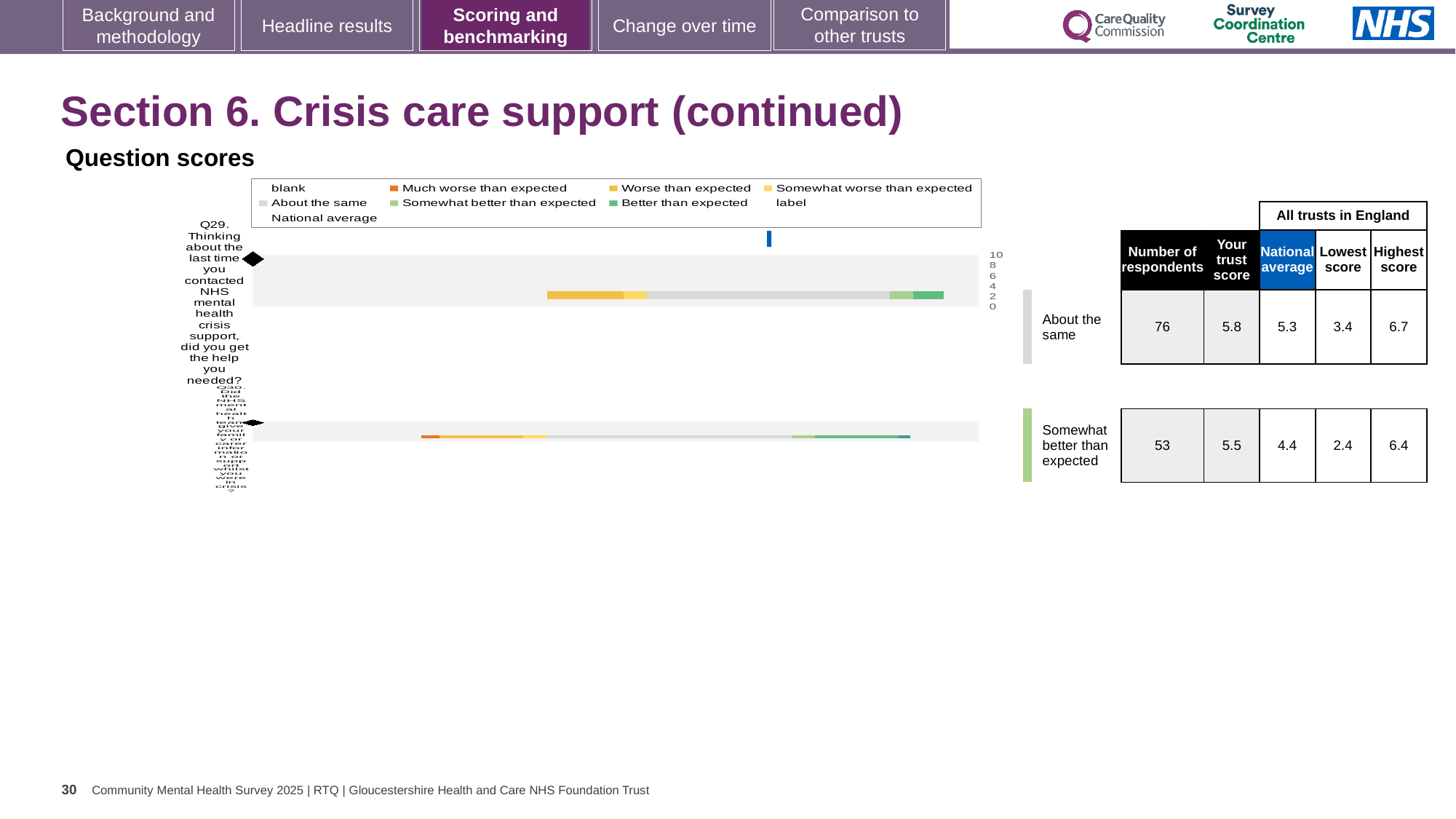
What kind of chart is used to show the question scores on this slide? Bar chart Which benchmark category is Q29 rated as? About the same What is the trust score for Q29 (Thinking about the last time you contacted NHS mental health crisis support, did you get the help you needed?)? 5.8 By how much does the trust score for Q29 exceed the national average for Q29? 0.5 Which benchmark category is Q30 rated as? Somewhat better than expected How many questions (categories) are plotted in the question scores chart? 2 What is the national average score for Q30? 4.4 What is the lowest score among all trusts in England for Q29? 3.4 What is the difference between the trust score and the national average for Q30? 1.1 Which question has the higher trust score, Q29 or Q30? Q29 What is the highest score among all trusts in England for Q30? 6.4 How many respondents answered Q29? 76